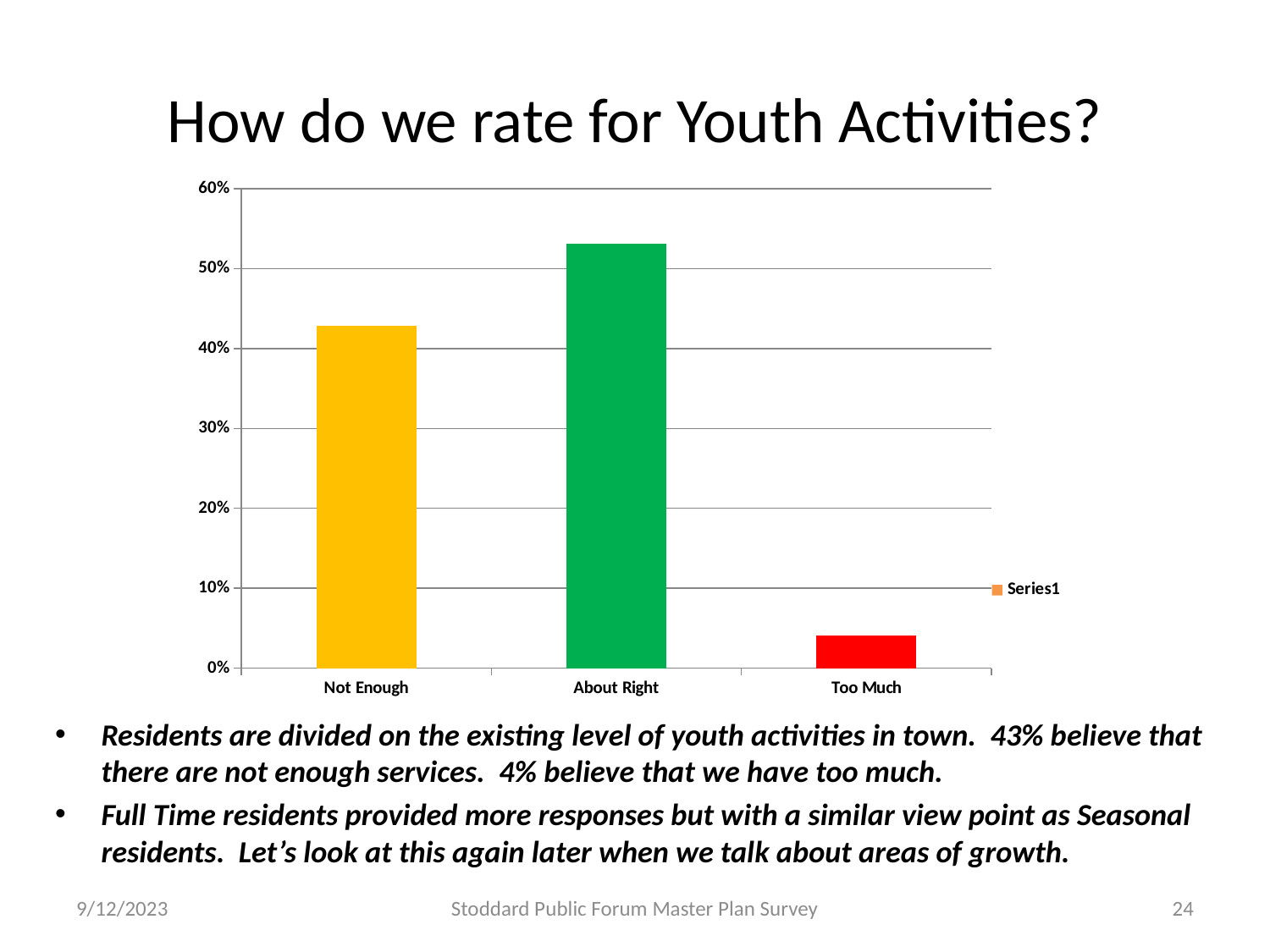
Which is larger, the value for Not Enough or the value for About Right? About Right According to the slide, what percentage of residents believe there are not enough youth activities? 43% Is the value for Too Much greater or less than 10%? less How many categories are shown on the x axis of the chart? 3 Is the value for About Right greater or less than 50%? greater What is the title of the slide containing the chart? How do we rate for Youth Activities? Is the value for Not Enough greater or less than 40%? greater What type of chart is shown on the slide? bar chart According to the slide, what percentage of residents believe there is too much in youth activities? 4% Which category has the highest value in the chart? About Right How many series does the legend list? 1 Which category has the lowest value in the chart? Too Much